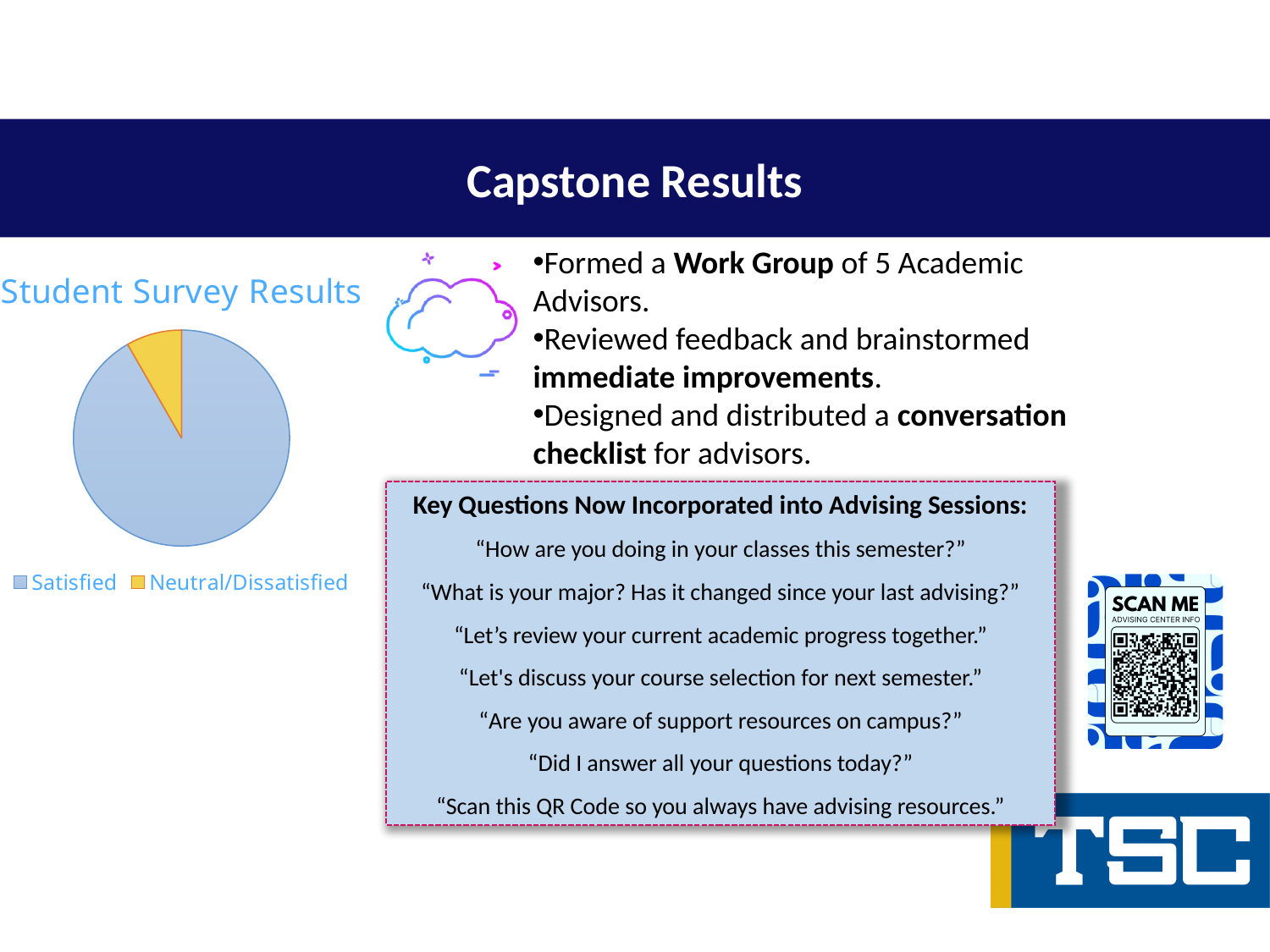
What is the title of the pie chart on the slide? Student Survey Results Which category has the largest slice in the Student Survey Results pie chart? Satisfied How many categories does the legend of the Student Survey Results pie chart list? 2 In the Student Survey Results pie chart, which slice is larger: Satisfied or Neutral/Dissatisfied? Satisfied How many slices does the Student Survey Results pie chart have? 2 What kind of chart is shown under "Student Survey Results"? Pie chart What colour is the Neutral/Dissatisfied slice in the Student Survey Results pie chart? Yellow Which category has the smallest slice in the Student Survey Results pie chart? Neutral/Dissatisfied